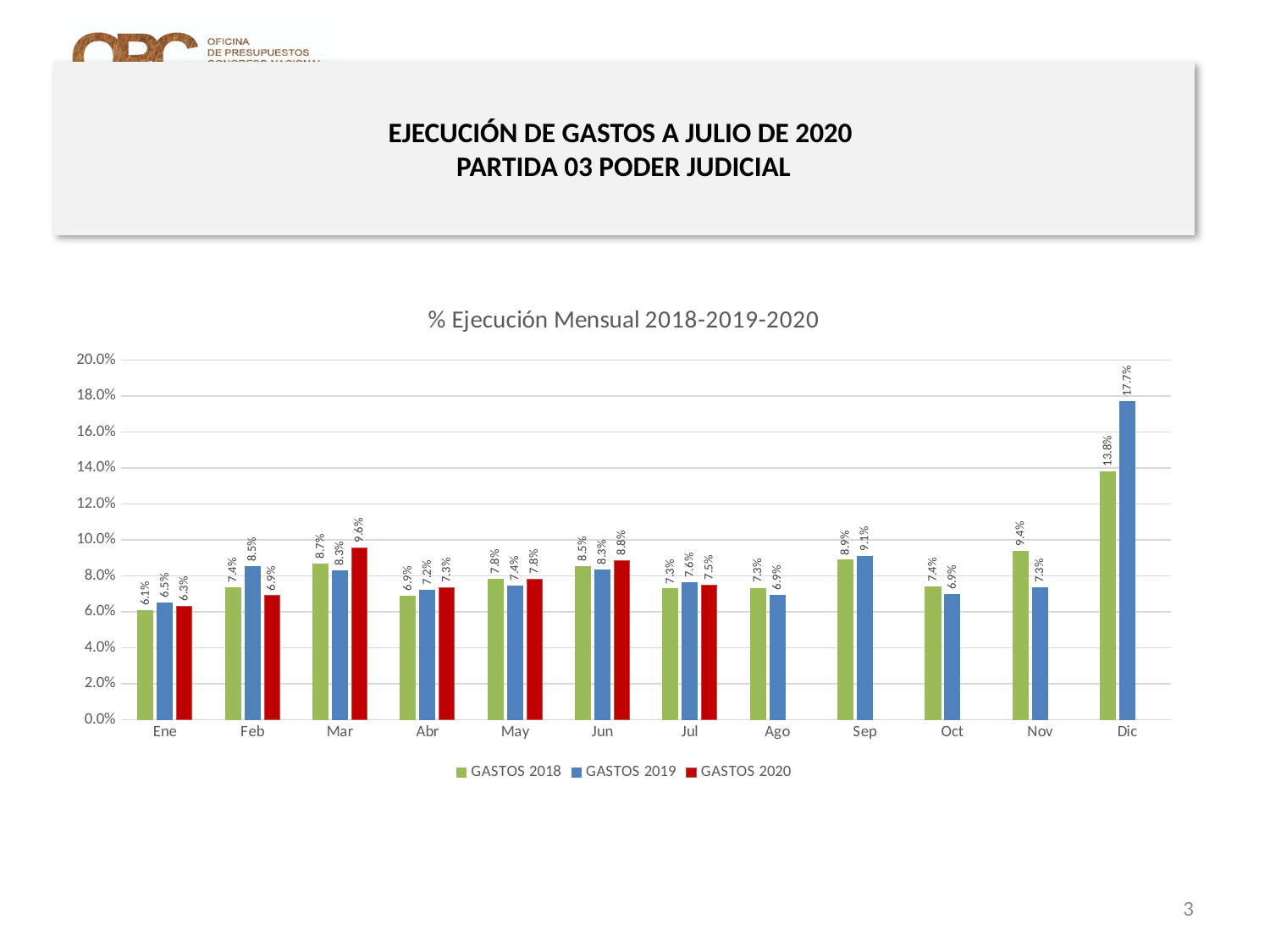
Which colour represents GASTOS 2020 in the legend? Red What is the value for GASTOS 2018 in Nov? 9.4% What is the value for GASTOS 2019 in Dic? 17.7% In which month is the GASTOS 2020 value lowest? Ene How many series does the legend list? 3 In which month is the GASTOS 2018 value highest? Dic What is the value for GASTOS 2020 in Mar? 9.6% What is the title of the chart? % Ejecución Mensual 2018-2019-2020 What kind of chart is shown? Bar chart What is the difference between GASTOS 2019 and GASTOS 2018 in Dic? 3.9% How many months have a GASTOS 2020 bar? 7 Which is larger in Feb: GASTOS 2019 or GASTOS 2020? GASTOS 2019